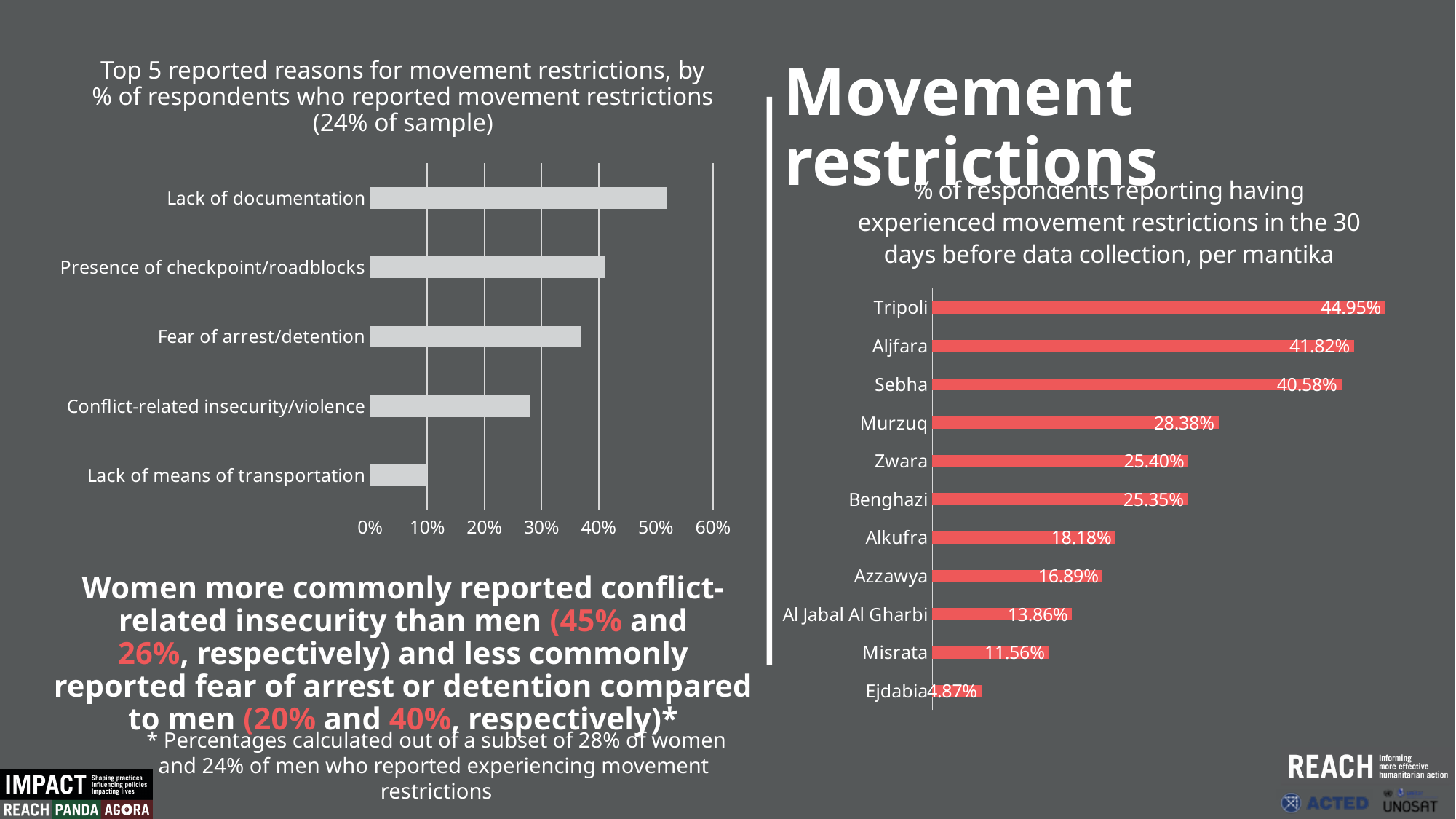
What kind of chart is the chart on the left (Top 5 reported reasons for movement restrictions)? Bar chart On the chart on the right (per mantika), what is the value for Murzuq? 28.38% On the chart on the right (per mantika), which mantika has the highest percentage? Tripoli On the chart on the left (Top 5 reported reasons for movement restrictions), is the value for Lack of documentation greater or less than 40%? greater On the chart on the right (per mantika), what is the difference between Tripoli and Aljfara? 3.13% On the chart on the left (Top 5 reported reasons for movement restrictions), which reason has the highest percentage? Lack of documentation On the chart on the right (per mantika), which mantika has the lowest percentage? Ejdabia On the chart on the right (per mantika), what is the value for Misrata? 11.56% On the chart on the right (% of respondents reporting movement restrictions per mantika), what is the value for Tripoli? 44.95% On the chart on the right (per mantika), how many mantikas are shown? 11 On the chart on the right (per mantika), which is larger, Alkufra or Azzawya? Alkufra On the chart on the left (Top 5 reported reasons for movement restrictions), is the value for Lack of means of transportation greater or less than 20%? less